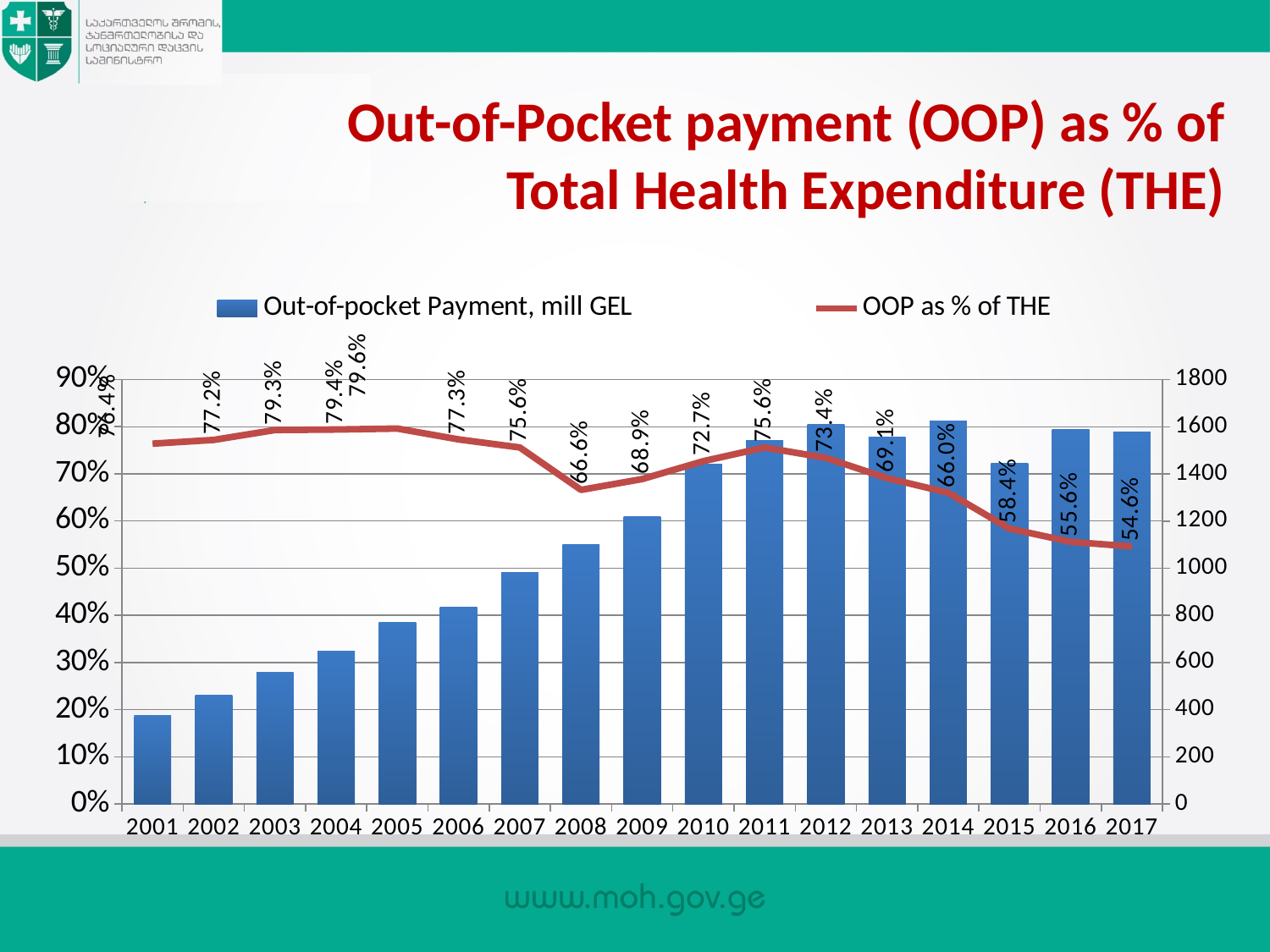
How many series does the legend list? 2 What is the OOP as % of THE value for 2017? 54.6% What is the OOP as % of THE value for 2005? 79.6% Which year has a higher OOP as % of THE, 2010 or 2013? 2010 In which year is OOP as % of THE highest? 2005 What is the OOP as % of THE value for 2008? 66.6% In which year is OOP as % of THE lowest? 2017 Is the Out-of-pocket Payment (mill GEL) bar for 2003 greater or less than 600? less Is the Out-of-pocket Payment (mill GEL) bar for 2017 greater or less than 1400? greater Does OOP as % of THE rise or fall from 2011 to 2017? fall How many years are shown on the x axis? 17 By how many percentage points did OOP as % of THE fall from 2001 to 2017? 21.8 percentage points